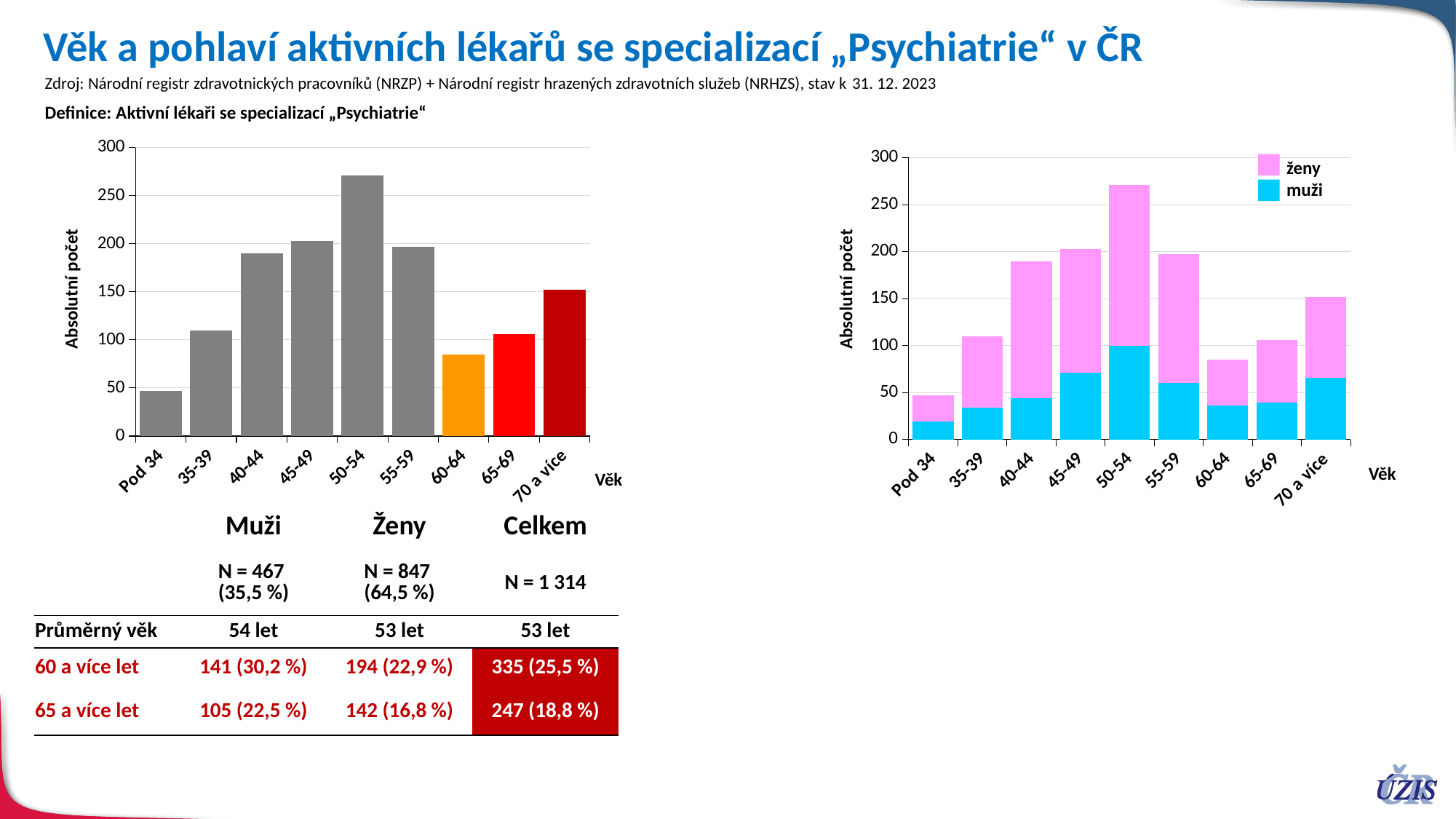
In the left chart, is the value for 50-54 greater or less than 250? greater What kind of chart is the left chart on the slide? bar chart In the left chart, which age group has the highest value? 50-54 In the left chart, which is larger: the value for 65-69 or the value for 70 a více? 70 a více How many series does the legend of the right chart list? 2 In the left chart, do the values rise or fall from 50-54 to 60-64? fall In the left chart, is the value for 60-64 greater or less than 100? less In the right chart, which age group has the tallest stacked bar? 50-54 In the right chart, is the muži value for 50-54 greater or less than 50? greater In the left chart, which age group has the lowest value? Pod 34 What are the two legend entries in the right chart? ženy, muži How many age groups are shown on the x axis of the left chart? 9